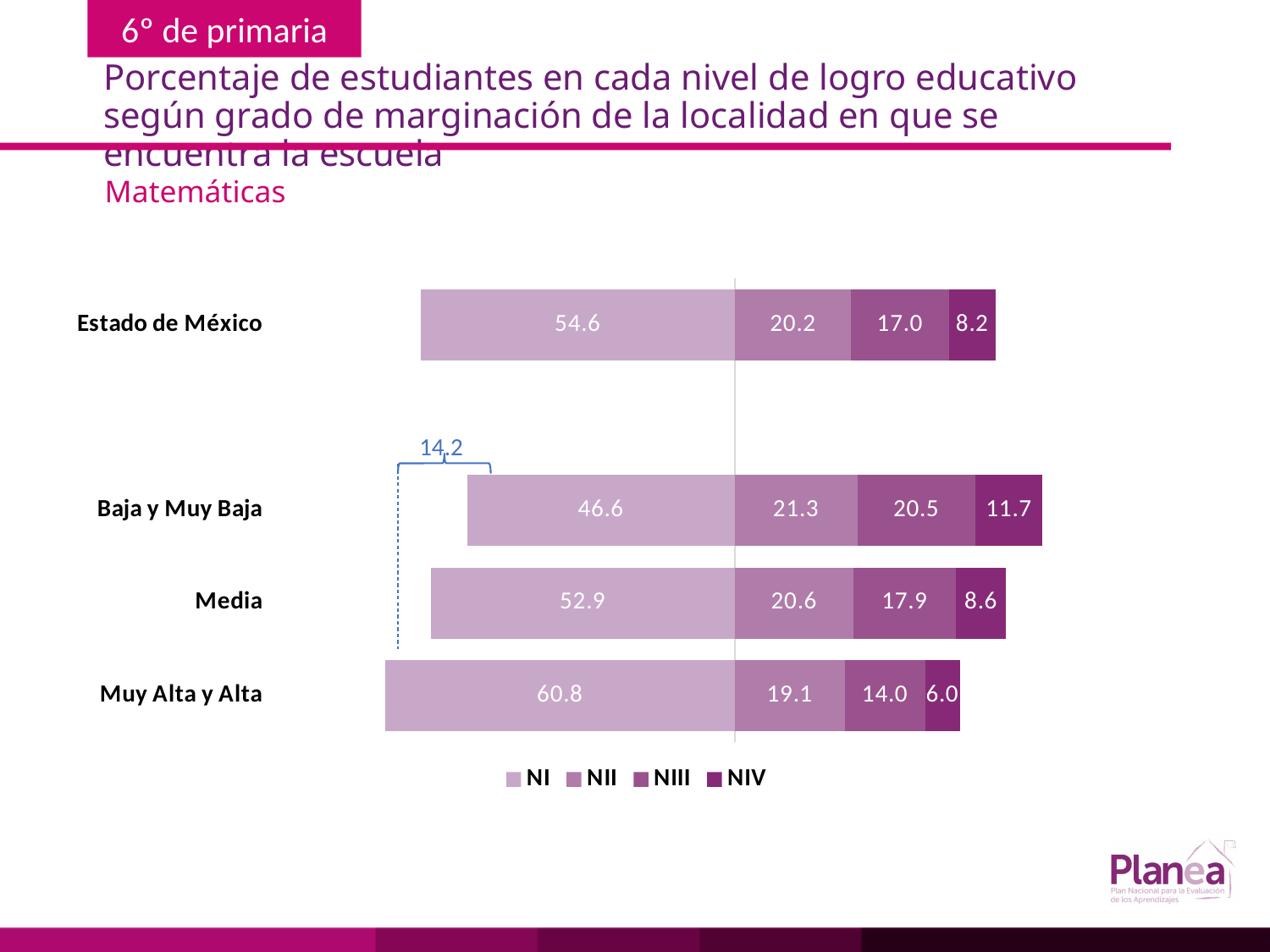
What is the NIII value for Media? 17.9 What kind of chart is shown on the slide? Stacked bar chart Which category has the lowest NIV value? Muy Alta y Alta What is the total of the stacked bar for Media? 100.0 How many categories are shown in the chart? 4 What is the NI value for Muy Alta y Alta? 60.8 What is the difference between the NI values for Muy Alta y Alta and Baja y Muy Baja? 14.2 Which is larger, the NIII value for Baja y Muy Baja or the NIII value for Estado de México? Baja y Muy Baja How many series does the legend list? 4 What is the NIV value for Baja y Muy Baja? 11.7 What is the NII value for Estado de México? 20.2 Which category has the highest NI value? Muy Alta y Alta